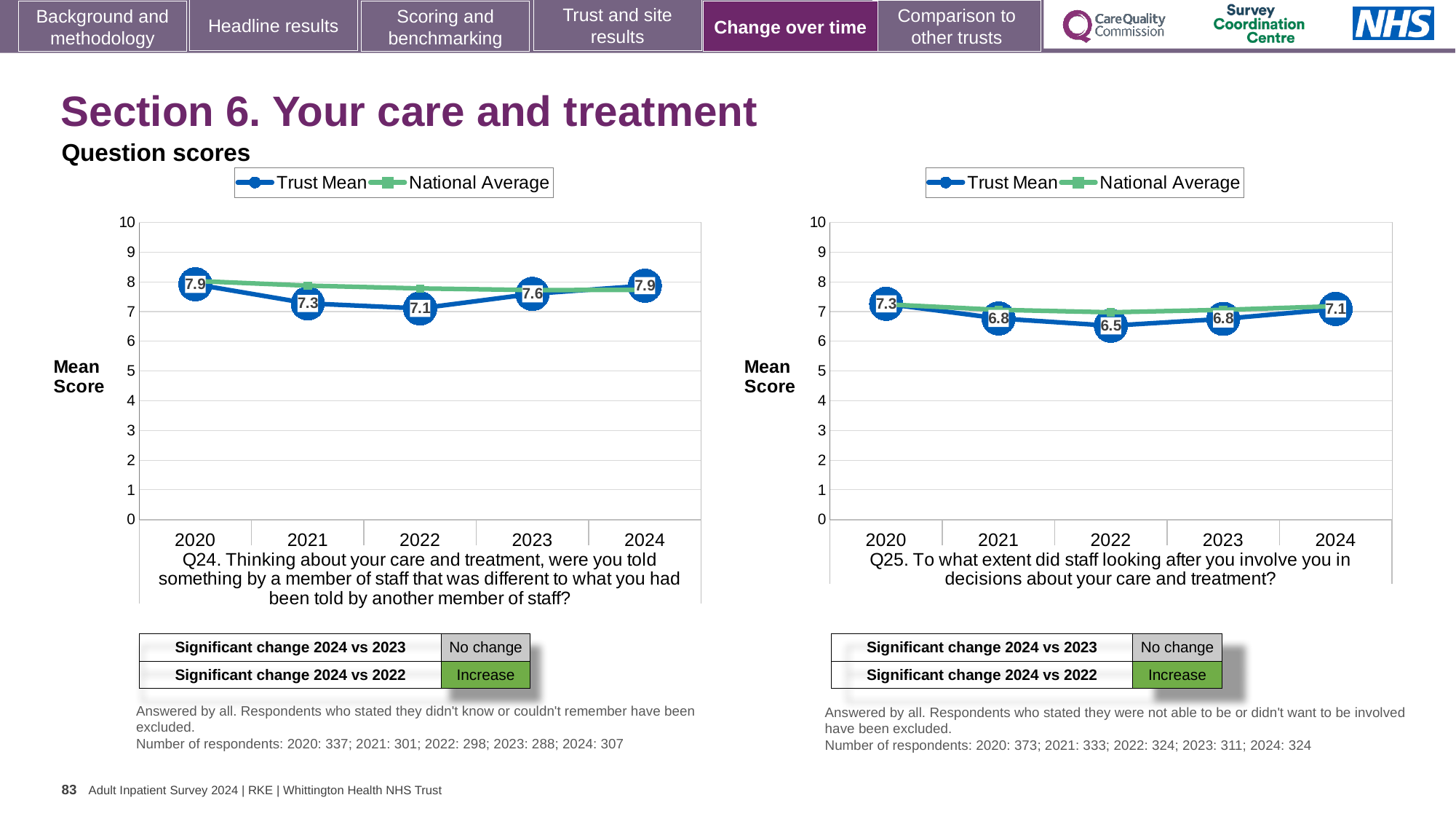
How many years are plotted on the x axis of the Q25 chart (right)? 5 How many series does the legend of the Q24 chart (left) list? 2 In the Q24 chart (left), what is the Trust Mean score for 2022? 7.1 In the Q25 chart (right), what is the Trust Mean score for 2024? 7.1 In the Q24 chart (left), which year has the lowest Trust Mean score? 2022 In the Q24 chart (left), is the National Average value for 2020 greater or less than 7? greater In the Q24 chart (left), what is the Trust Mean score for 2023? 7.6 In the Q25 chart (right), is the Trust Mean score for 2021 larger or smaller than the score for 2024? smaller What type of chart is used for Q25 (right)? line chart In the Q24 chart (left), what is the difference between the Trust Mean scores for 2024 and 2022? 0.8 In the Q25 chart (right), which year has the highest Trust Mean score? 2020 In the Q25 chart (right), which year has the lowest Trust Mean score? 2022